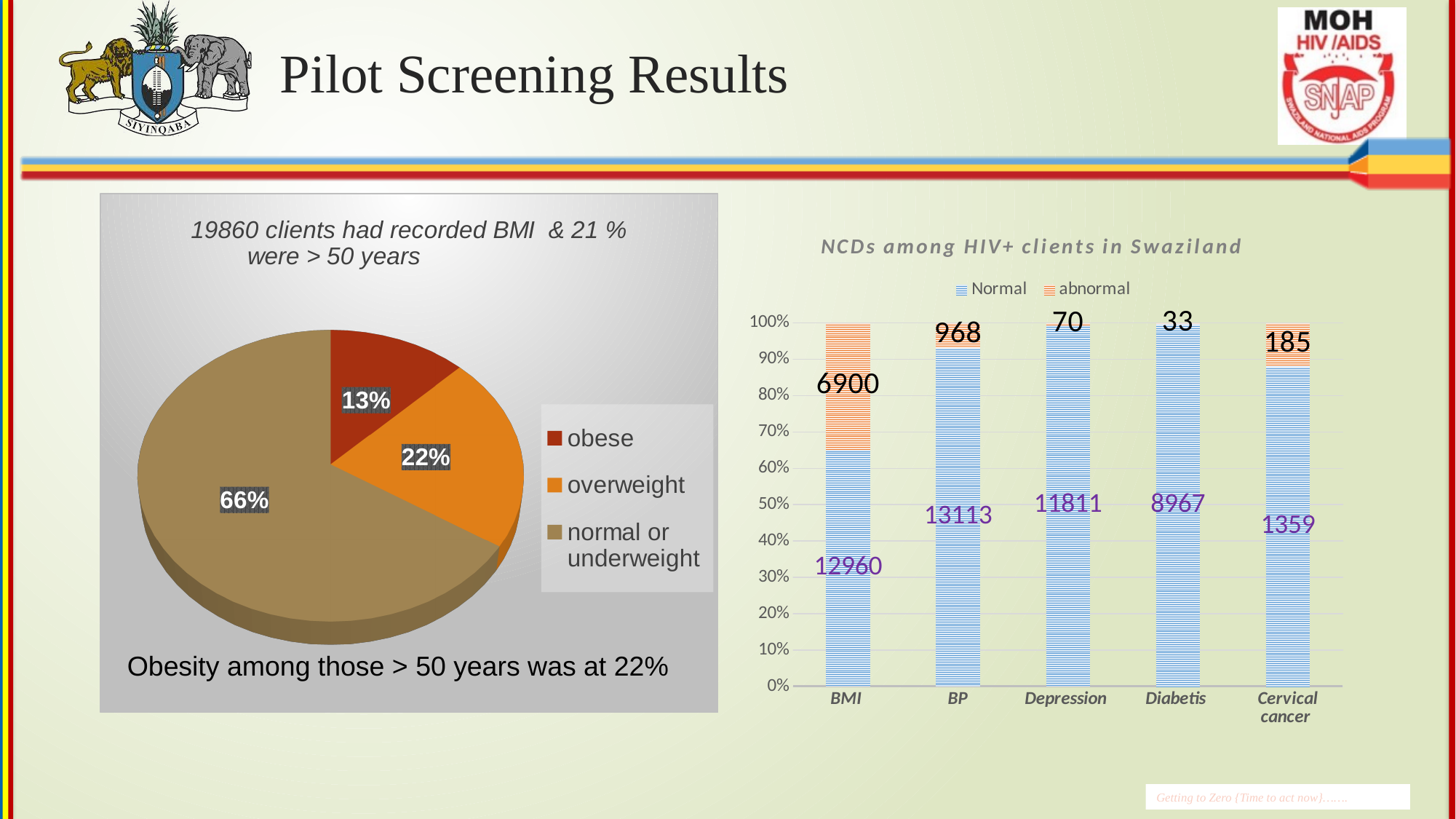
In the chart titled 'NCDs among HIV+ clients in Swaziland', what is the abnormal value for Cervical cancer? 185 In the pie chart on the left, what percentage of clients were obese? 13% In the chart titled 'NCDs among HIV+ clients in Swaziland', which category has the lowest Normal value? Cervical cancer In the chart titled 'NCDs among HIV+ clients in Swaziland', what is the Normal value for BMI? 12960 In the pie chart on the left, how many categories does the legend list? 3 In the pie chart on the left, which category has the smallest share? obese In the chart titled 'NCDs among HIV+ clients in Swaziland', how many series does the legend list? 2 In the pie chart on the left, which category has the largest share? normal or underweight In the chart titled 'NCDs among HIV+ clients in Swaziland', what is the difference between the Normal values for BP and Depression? 1302 In the pie chart on the left, what percentage of clients were overweight? 22% In the chart titled 'NCDs among HIV+ clients in Swaziland', which category has the highest abnormal value? BMI In the chart titled 'NCDs among HIV+ clients in Swaziland', what is the total of the Normal and abnormal values for Diabetis? 9000